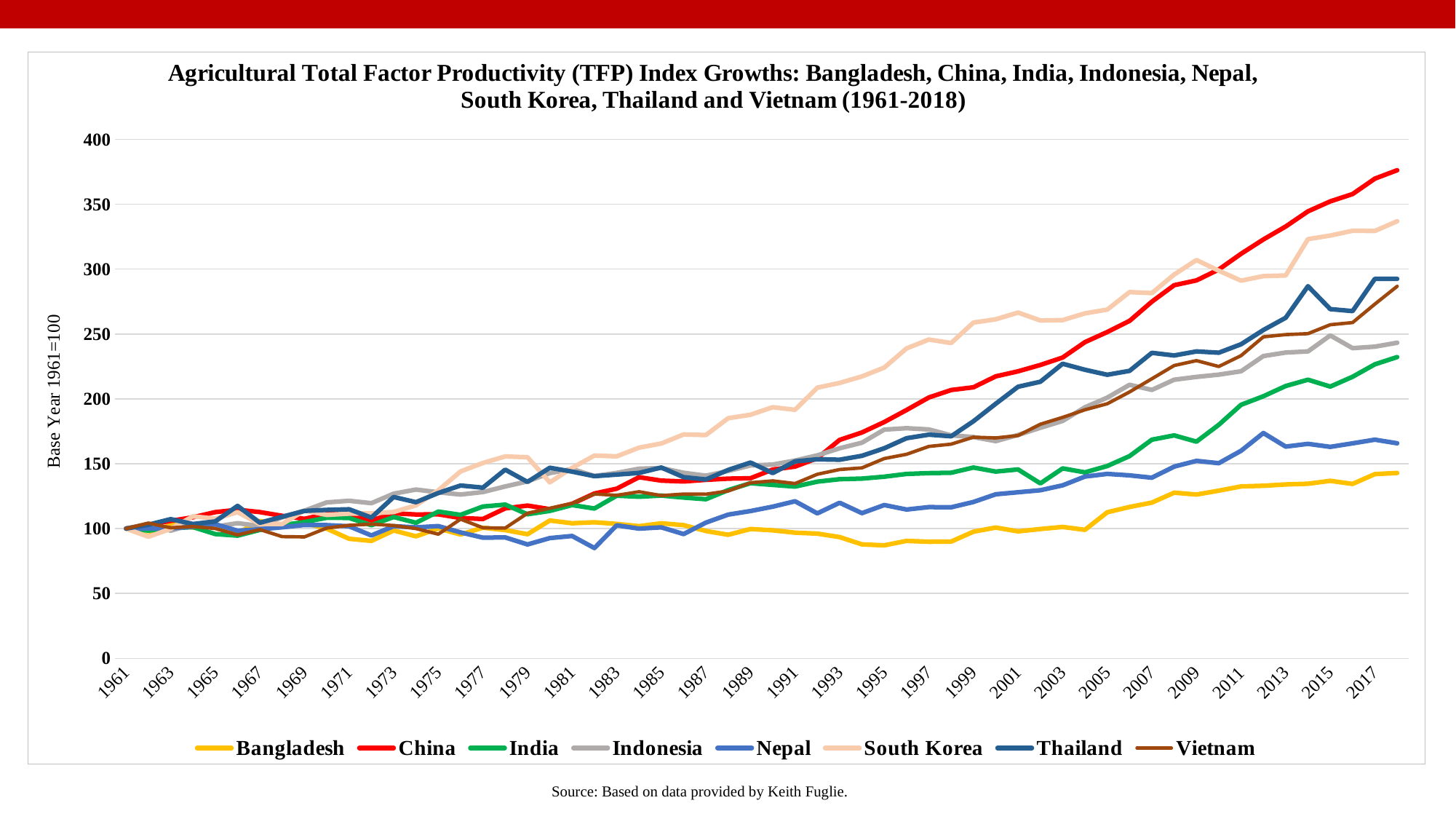
What kind of chart is shown on the slide? line chart Is the value for India in 2017 greater or less than 200? greater What is the title of the vertical axis? Base Year 1961=100 How many series does the legend list? 8 What is the TFP index value for every country in the base year 1961? 100 In 2017, which is larger: the value for South Korea or the value for Indonesia? South Korea Is the value for Thailand in 2017 greater or less than 250? greater Which country has the lowest TFP index value in 2018? Bangladesh Does the TFP index for China rise or fall from 1961 to 2018? rise Is the value for China in 2017 greater or less than 350? greater Which country has the highest TFP index value in 2018? China